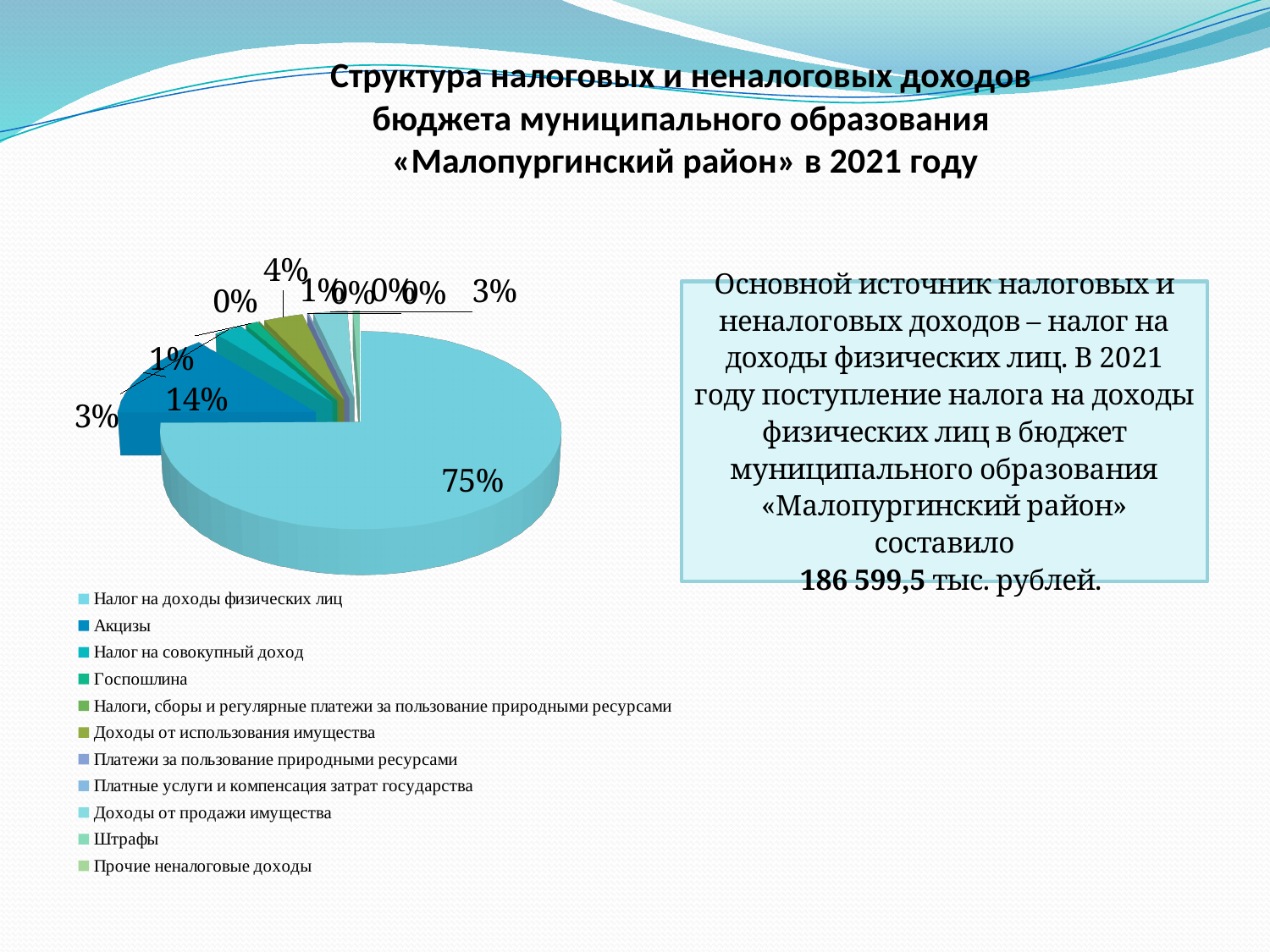
Which year does the chart title say the revenue structure refers to? 2021 What share of the pie does "Доходы от использования имущества" have? 4% What share of the pie does "Налог на совокупный доход" have? 3% What kind of chart is shown on the slide? Pie chart What share of the pie does "Налог на доходы физических лиц" have? 75% What share of the pie does "Акцизы" have? 14% Which is larger, the slice for "Акцизы" or the slice for "Доходы от использования имущества"? Акцизы Which is larger, the slice for "Акцизы" or the slice for "Налог на доходы физических лиц"? Налог на доходы физических лиц Which category has the largest slice of the pie? Налог на доходы физических лиц How many categories does the legend of the pie chart list? 11 According to the text box on the slide, how much personal income tax was received by the budget in 2021? 186 599,5 тыс. рублей By how many percentage points does the share of "Налог на доходы физических лиц" exceed the share of "Акцизы"? 61 percentage points